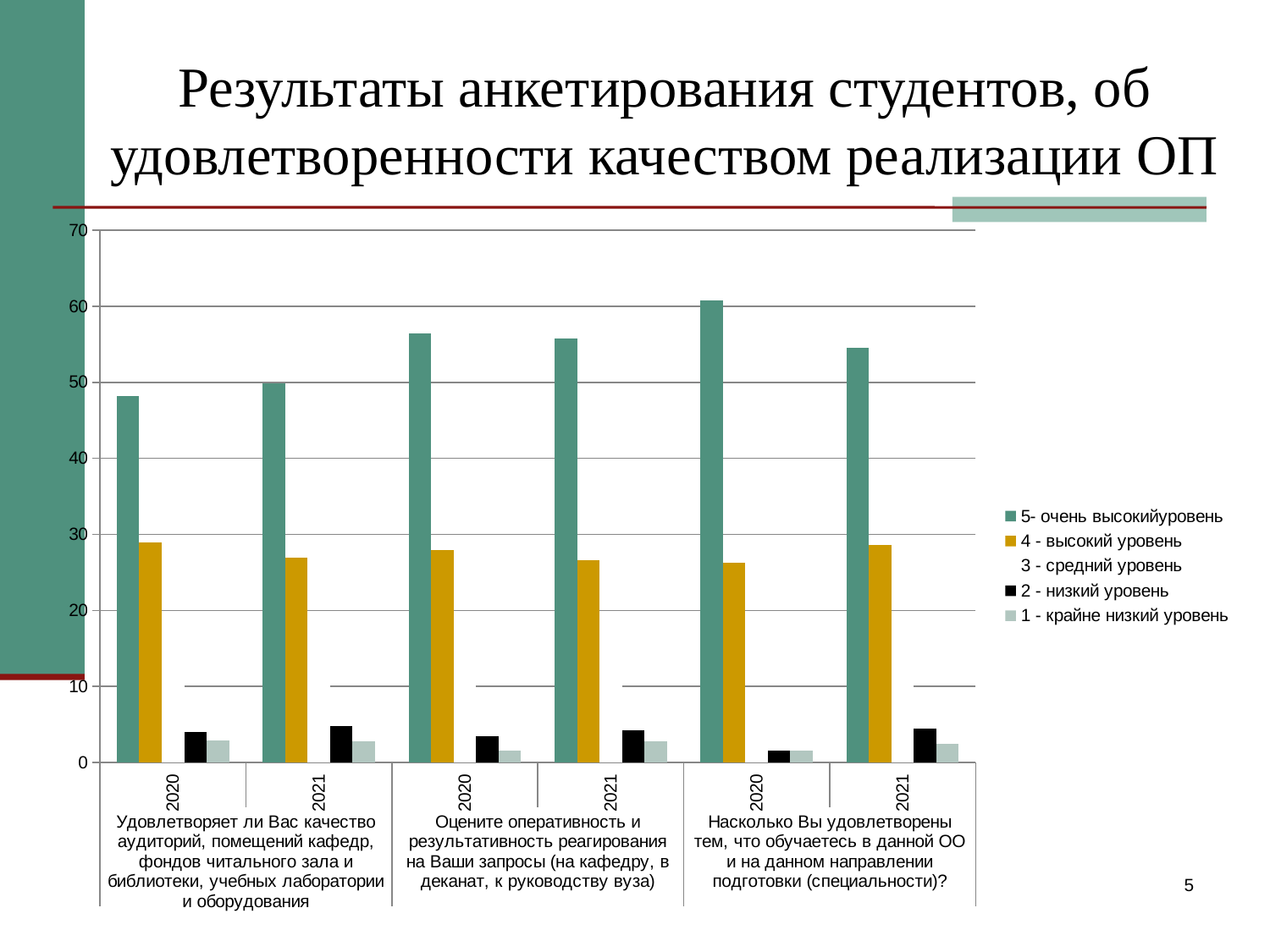
For which survey question and year is the '5- очень высокий уровень' bar the tallest? Насколько Вы удовлетворены тем, что обучаетесь в данной ОО и на данном направлении подготовки (специальности)?, 2020 Is the '4 - высокий уровень' value for 2020 under 'Удовлетворяет ли Вас качество аудиторий...' greater or less than 20? greater For 'Насколько Вы удовлетворены тем, что обучаетесь...', does the '5- очень высокий уровень' value rise or fall from 2020 to 2021? fall How many series does the legend list? 5 Is the '5- очень высокий уровень' value for 2020 under 'Насколько Вы удовлетворены тем, что обучаетесь...' greater or less than 60? greater How many survey questions are shown along the x axis? 3 Is the '1 - крайне низкий уровень' value for 2020 under 'Оцените оперативность и результативность реагирования...' greater or less than 10? less What kind of chart is shown on the slide? bar chart How many year labels (2020/2021) appear along the x axis in total? 6 For 'Насколько Вы удовлетворены тем, что обучаетесь...', which year has the higher '5- очень высокий уровень' bar, 2020 or 2021? 2020 What colour represents '4 - высокий уровень' in the legend? yellow (gold)